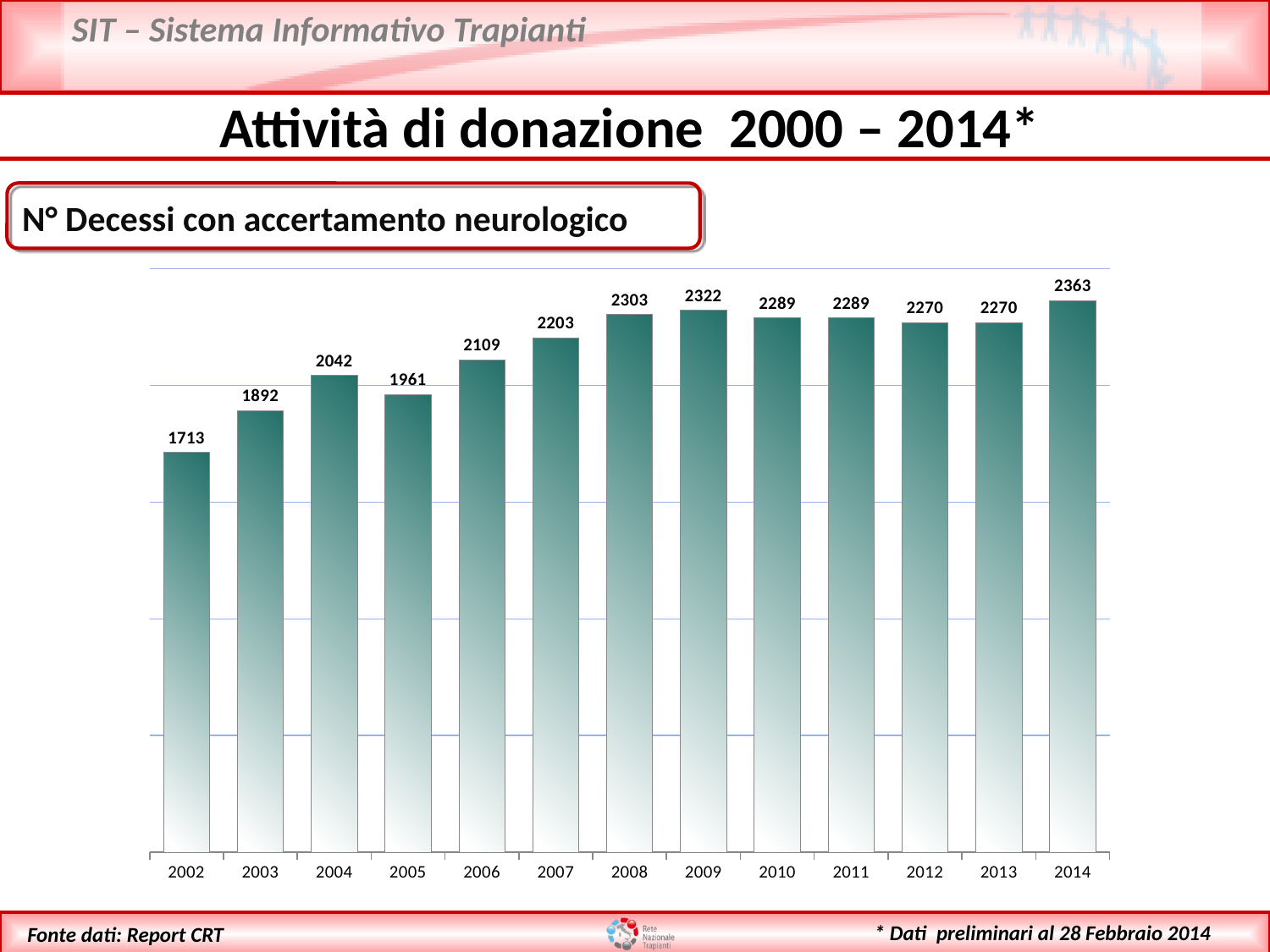
What is the value for 2009? 2322 What is the label in the box above the chart? N° Decessi con accertamento neurologico Which year has the lowest value? 2002 What is the difference between the values for 2014 and 2002? 650 Which is larger, the value for 2006 or the value for 2007? 2007 What is the difference between the values for 2004 and 2005? 81 What is the value for 2014? 2363 How many years are shown on the x axis? 13 What kind of chart is shown? bar chart Which year has the highest value? 2014 Do the values generally rise or fall from 2002 to 2009? rise What is the value for 2002? 1713